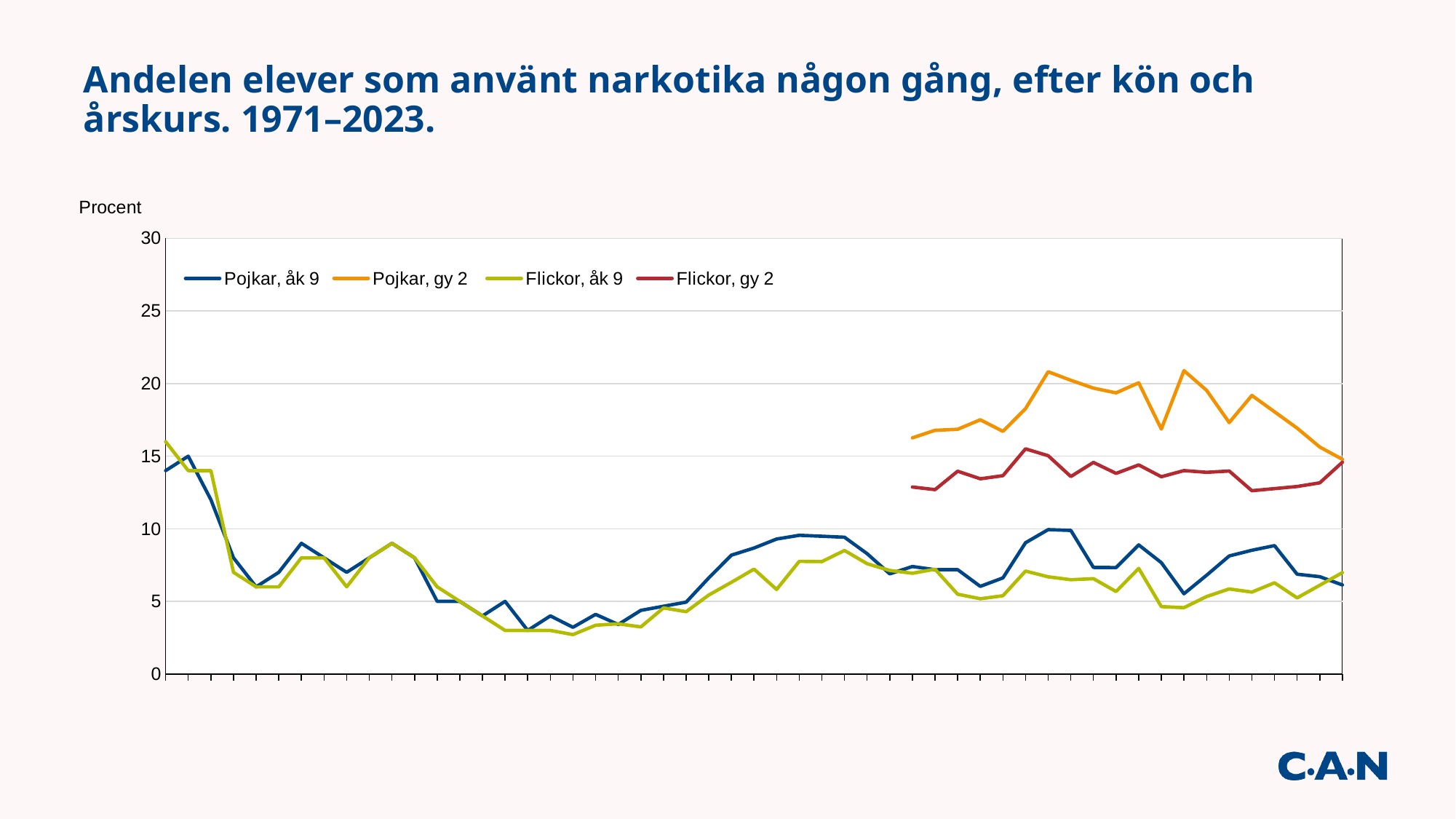
Which series is higher at the right end of the chart, Pojkar, gy 2 or Pojkar, åk 9? Pojkar, gy 2 What is the highest value shown on the vertical axis? 30 Which series reaches the highest values on the chart? Pojkar, gy 2 Is the lowest value of the Flickor, åk 9 series greater or less than 5? less Is the highest value of the Pojkar, åk 9 series greater or less than 20? less Which series is higher over the last part of the chart, Flickor, gy 2 or Flickor, åk 9? Flickor, gy 2 Is the peak value of the Pojkar, gy 2 series greater or less than 20? greater Does the Pojkar, gy 2 series rise or fall over its final stretch toward the right end of the chart? fall What kind of chart is shown on the slide? line chart What is the label on the vertical axis? Procent How many series does the legend list? 4